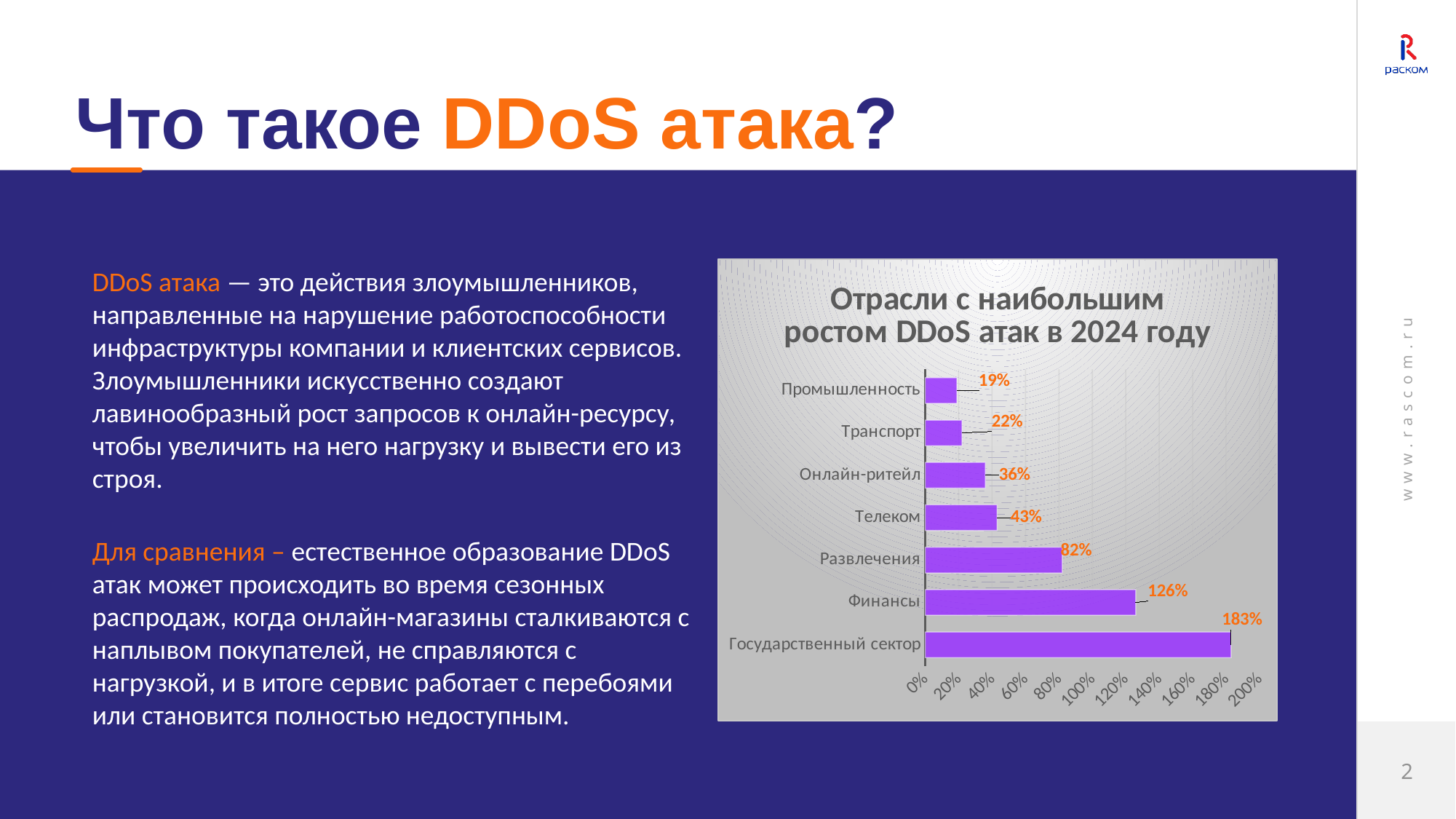
What is the value for Финансы? 126% Which is larger, the value for Развлечения or the value for Телеком? Развлечения What kind of chart is shown on the slide? Bar chart How many categories are shown in the chart? 7 What is the value for Промышленность? 19% What is the difference between the values for Государственный сектор and Финансы? 57% What is the value for Государственный сектор? 183% Which category has the lowest value? Промышленность What is the value for Телеком? 43% What is the title of the chart? Отрасли с наибольшим ростом DDoS атак в 2024 году Which category has the highest value? Государственный сектор What is the difference between the values for Онлайн-ритейл and Транспорт? 14%